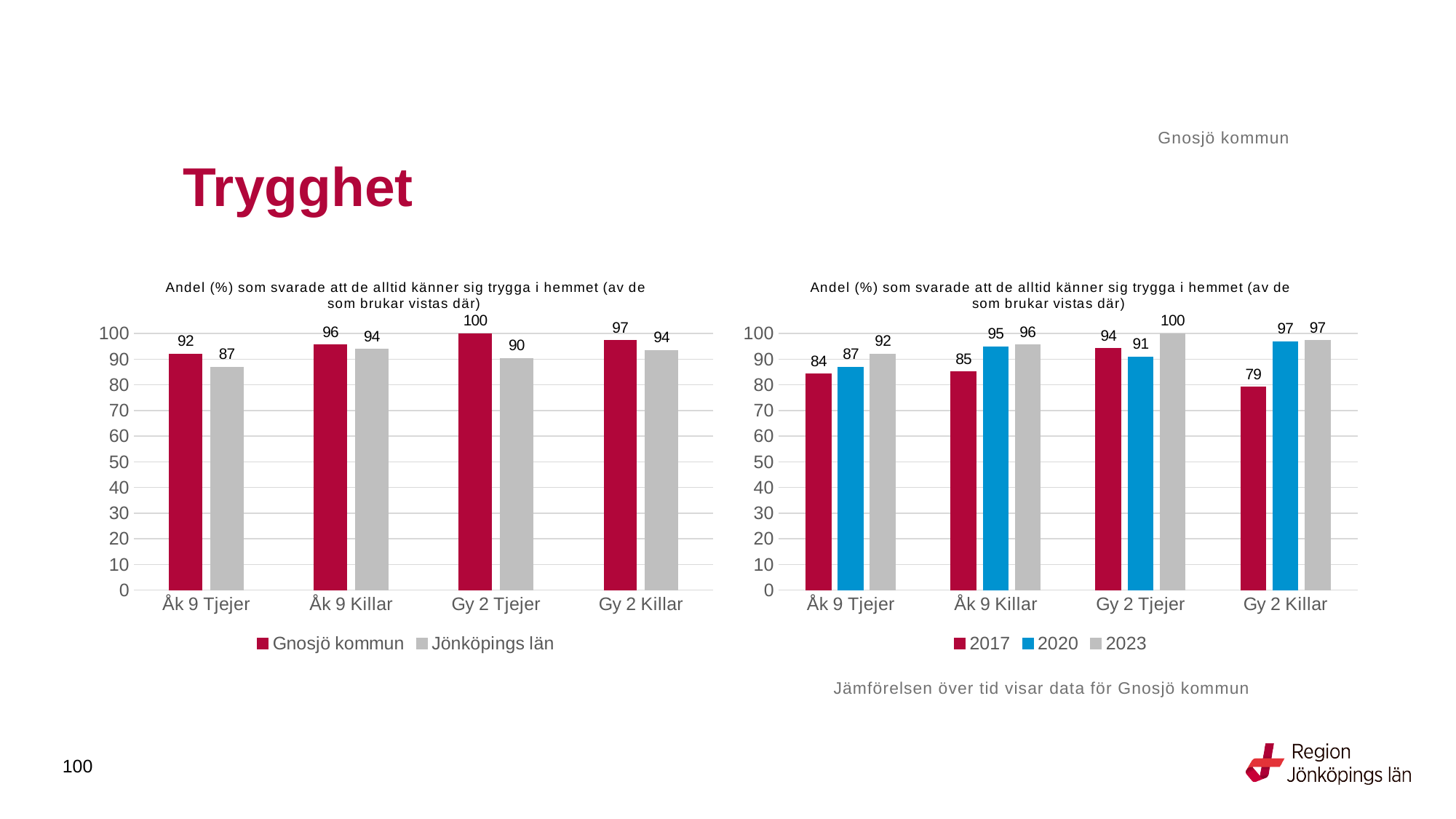
In the right chart, what is the value for 2017 for Gy 2 Killar? 79 In the left chart, what is the difference between Gnosjö kommun and Jönköpings län for Gy 2 Tjejer? 10 In the left chart, how many series does the legend list? 2 In the right chart, which is larger for Gy 2 Tjejer: the 2017 value or the 2020 value? 2017 In the right chart, which category has the highest value for 2023? Gy 2 Tjejer What kind of chart is the right chart? Bar chart In the left chart, what is the value for Gnosjö kommun for Gy 2 Tjejer? 100 In the right chart, how many categories are shown on the x axis? 4 In the right chart, what is the value for 2020 for Åk 9 Killar? 95 In the left chart, which category has the lowest value for Jönköpings län? Åk 9 Tjejer In the right chart, what is the difference between the 2023 and 2017 values for Gy 2 Killar? 18 In the left chart, what is the value for Jönköpings län for Åk 9 Tjejer? 87